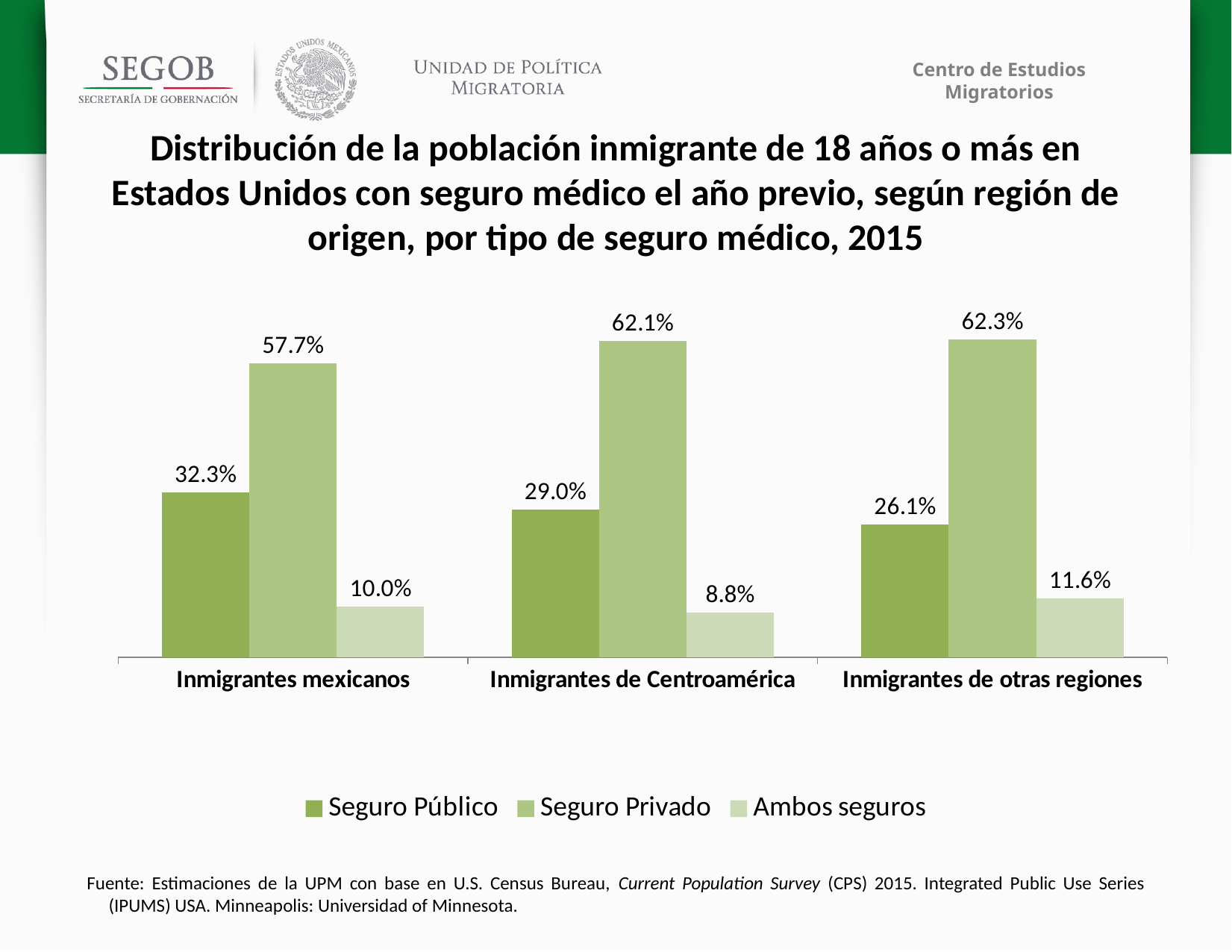
What is the value of Ambos seguros for Inmigrantes de otras regiones? 11.6% What kind of chart is shown on the slide? Bar chart What is the value of Seguro Público for Inmigrantes de Centroamérica? 29.0% Which category has the lowest value for Ambos seguros? Inmigrantes de Centroamérica Which category has the highest value for Seguro Público? Inmigrantes mexicanos Which is larger for Inmigrantes mexicanos: Seguro Público or Ambos seguros? Seguro Público What is the difference between Seguro Privado and Seguro Público for Inmigrantes de otras regiones? 36.2% What is the value of Seguro Privado for Inmigrantes mexicanos? 57.7% What is the name of the third series in the legend? Ambos seguros Does the value of Seguro Público rise or fall across the categories from left to right? Fall How many categories are shown on the x axis? 3 How many series does the legend list? 3